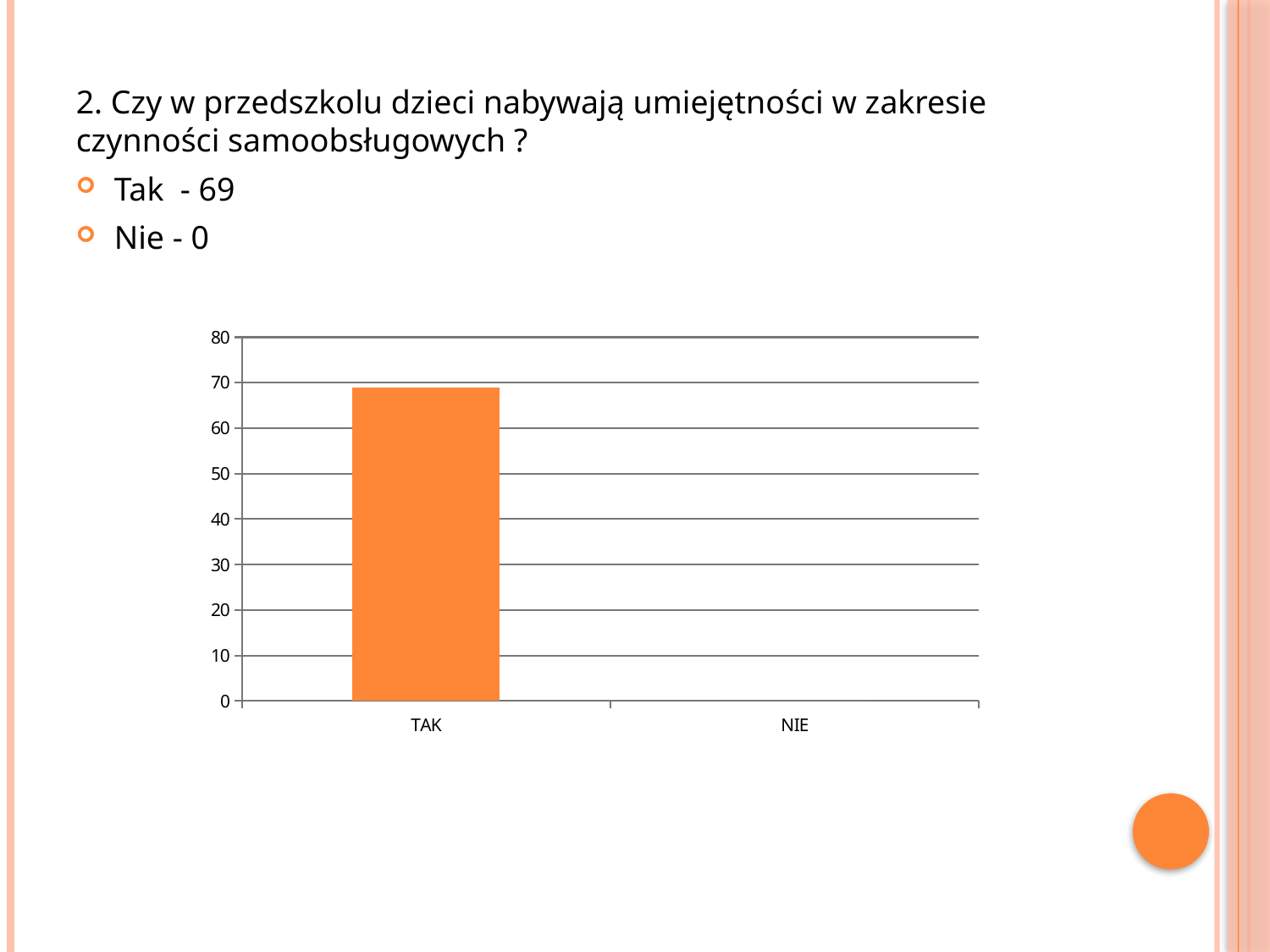
What colour is the bar for TAK in the chart? orange Which is larger, the value for TAK or the value for NIE? TAK What is the value for TAK in the chart? 69 Which category has the lowest value in the chart? NIE What is the value for NIE in the chart? 0 What is the highest tick value shown on the y axis of the chart? 80 Is the value for TAK greater or less than 70? less Is the value for TAK greater or less than 60? greater What is the difference between the values for TAK and NIE? 69 How many categories are shown on the x axis of the chart? 2 Which category has the highest value in the chart? TAK What kind of chart is shown on the slide? bar chart